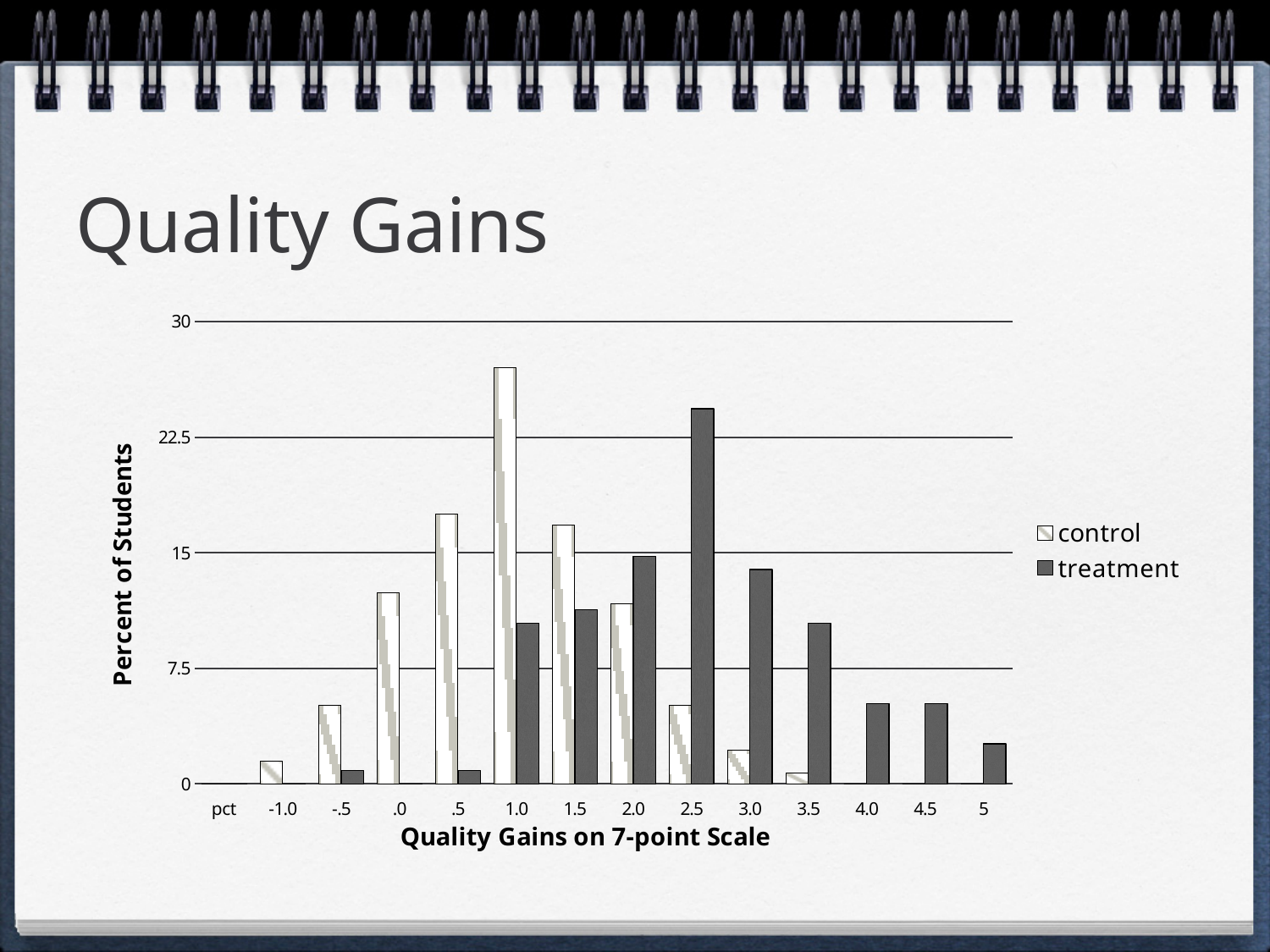
Is the treatment value at 4.0 greater or less than 7.5? less At which quality gain value is the control series highest? 1.0 At a quality gain of 3.5, which series has the larger value, control or treatment? treatment At which quality gain value is the treatment series highest? 2.5 What is the title of the vertical axis? Percent of Students Is the treatment value at 2.5 greater or less than 22.5? greater What are the two series named in the legend? control and treatment Is the control value at 1.0 greater or less than 22.5? greater What kind of chart is shown on the slide? bar chart At a quality gain of 1.0, which series has the larger value, control or treatment? control How many series does the legend list? 2